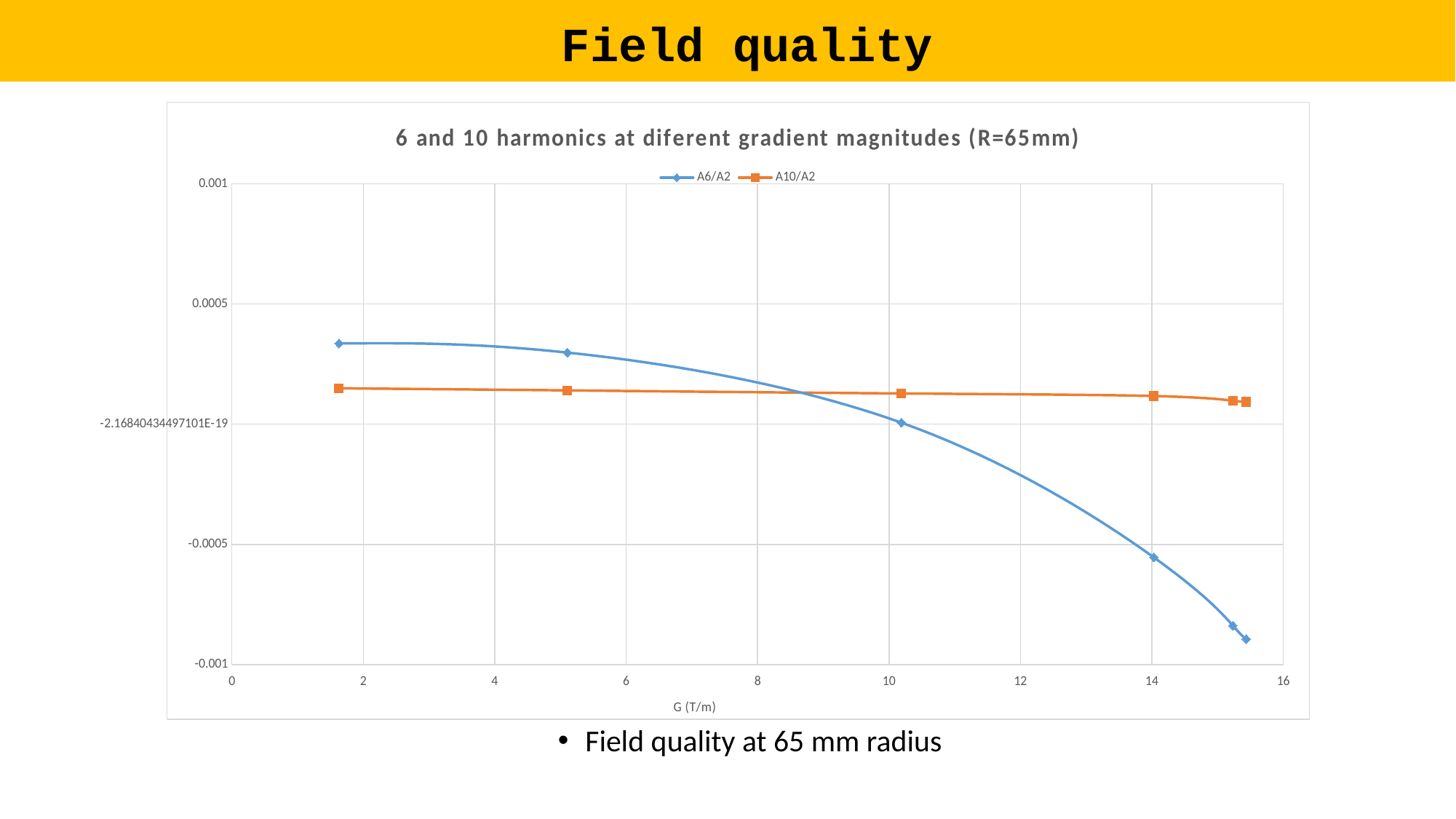
What kind of chart is shown on the slide? line chart Which series reaches the lowest value on the chart? A6/A2 Is the A10/A2 value at G of about 10 T/m greater or less than 0.0005? less What is the title of the chart? 6 and 10 harmonics at diferent gradient magnitudes (R=65mm) What are the two series named in the chart legend? A6/A2 and A10/A2 At G of about 14 T/m, which series has the higher value, A6/A2 or A10/A2? A10/A2 At G of about 2 T/m, which series has the higher value, A6/A2 or A10/A2? A6/A2 Is the A6/A2 value at the highest plotted G (around 15.5 T/m) greater or less than -0.0005? less How many series does the chart legend list? 2 How many data points are plotted for the A6/A2 series? 6 Does the A6/A2 series rise or fall as G (T/m) increases? fall Is the A6/A2 value at the lowest plotted G (around 2 T/m) greater or less than 0.0005? less